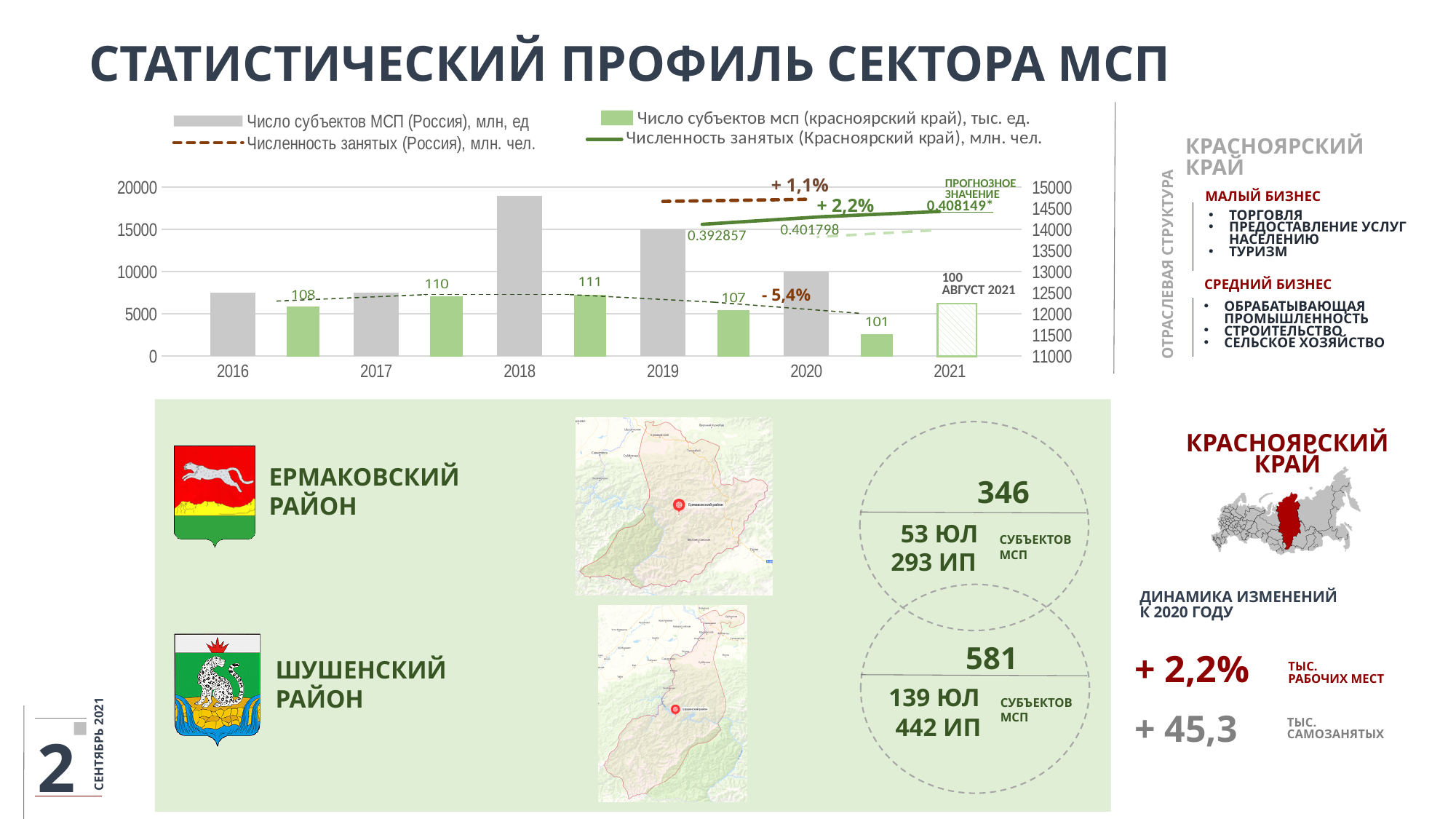
In which year is Число субъектов МСП (Красноярский край) highest? 2018 What is the value of Число субъектов МСП (Красноярский край) for 2020? 101 What is the value of Число субъектов МСП (Красноярский край) for 2018? 111 Is the grey bar for Число субъектов МСП (Россия) in 2016 greater or less than 10000? less In which year is the labelled value of Число субъектов МСП (Красноярский край) lowest? 2021 Do the values of Число субъектов МСП (Красноярский край) rise or fall from 2018 to 2021? fall Which year has the larger value of Число субъектов МСП (Красноярский край): 2017 or 2019? 2017 How many series does the chart legend list? 4 What is the difference between Число субъектов МСП (Красноярский край) in 2018 and in 2020? 10 What is the forecast value (прогнозное значение) of Численность занятых (Красноярский край) for 2021? 0,408149* What is the labelled value of Численность занятых (Красноярский край) for 2019? 0.392857